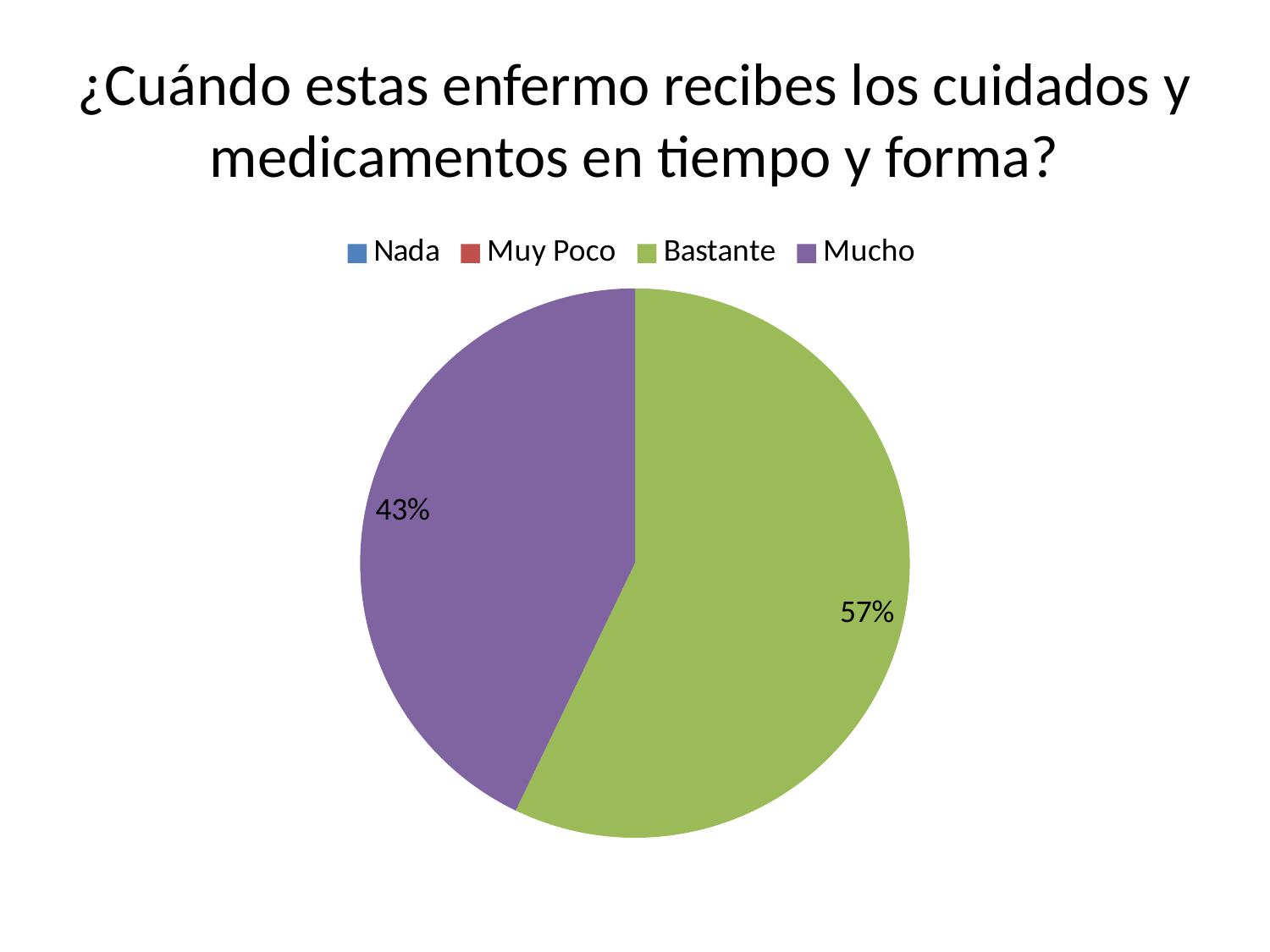
Which category has the largest slice of the pie? Bastante Is the share for Mucho greater or less than 50%? less What colour is the Bastante slice? Green What share of the pie does Bastante represent? 57% What is the difference in percentage points between the Bastante and Mucho slices? 14 How many slices are visible in the pie? 2 How many entries does the legend list? 4 What is the title of the chart? ¿Cuándo estas enfermo recibes los cuidados y medicamentos en tiempo y forma? Which is larger, the slice for Bastante or the slice for Mucho? Bastante What share of the pie does Mucho represent? 43% What kind of chart is shown on the slide? Pie chart